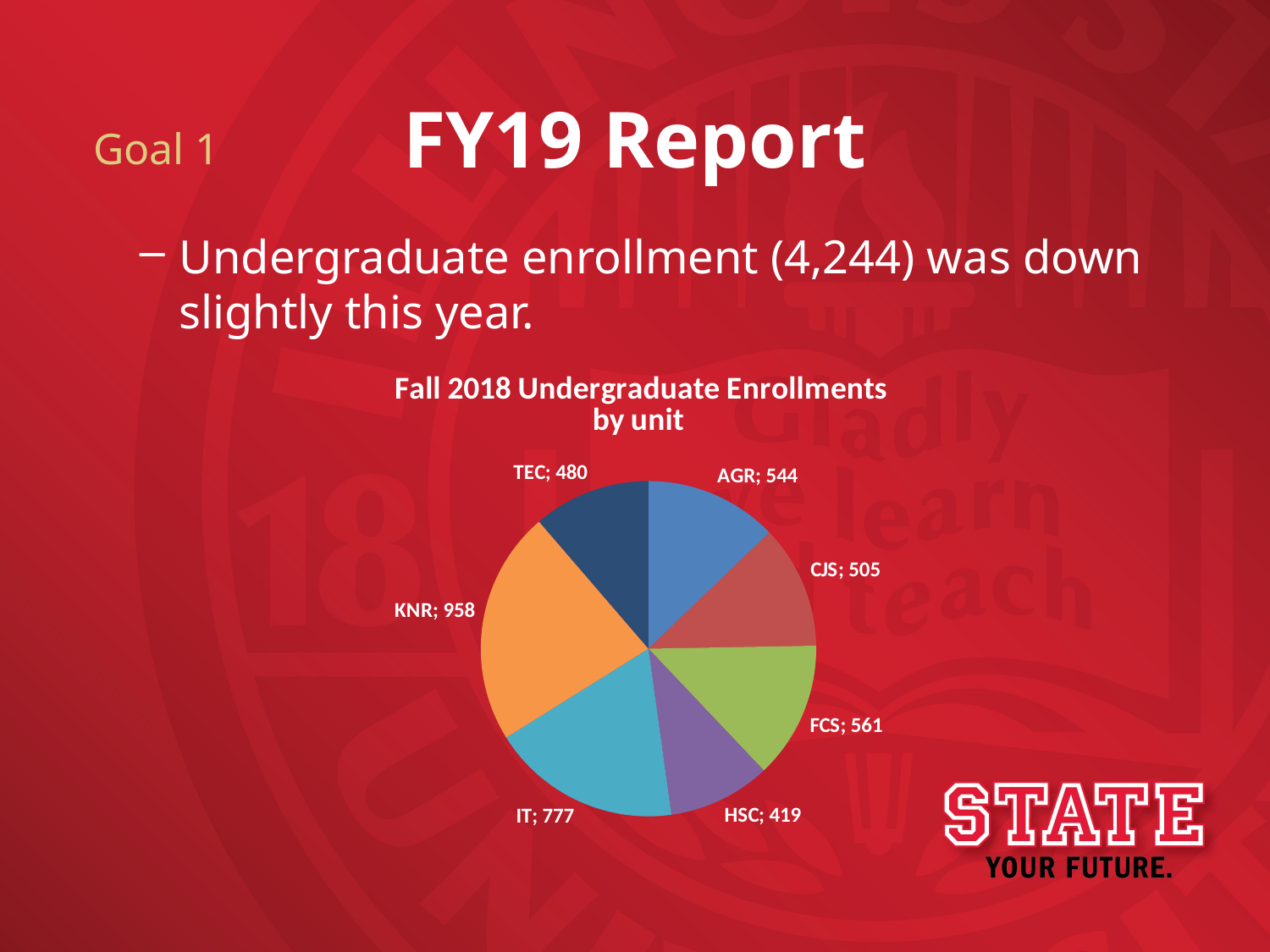
Which unit has the largest slice of the pie chart? KNR Which unit has the smallest slice of the pie chart? HSC How many units are shown in the pie chart? 7 What is the enrollment value shown for TEC? 480 What is the total of all the enrollment values shown in the pie chart? 4,244 What is the enrollment value shown for KNR in the pie chart? 958 Which has a larger enrollment value, AGR or CJS? AGR What is the title of the chart on the slide? Fall 2018 Undergraduate Enrollments by unit What is the difference between the KNR and IT enrollment values? 181 What type of chart is used to show Fall 2018 undergraduate enrollments by unit? Pie chart What is the enrollment value shown for HSC? 419 What is the difference between the FCS and CJS enrollment values? 56